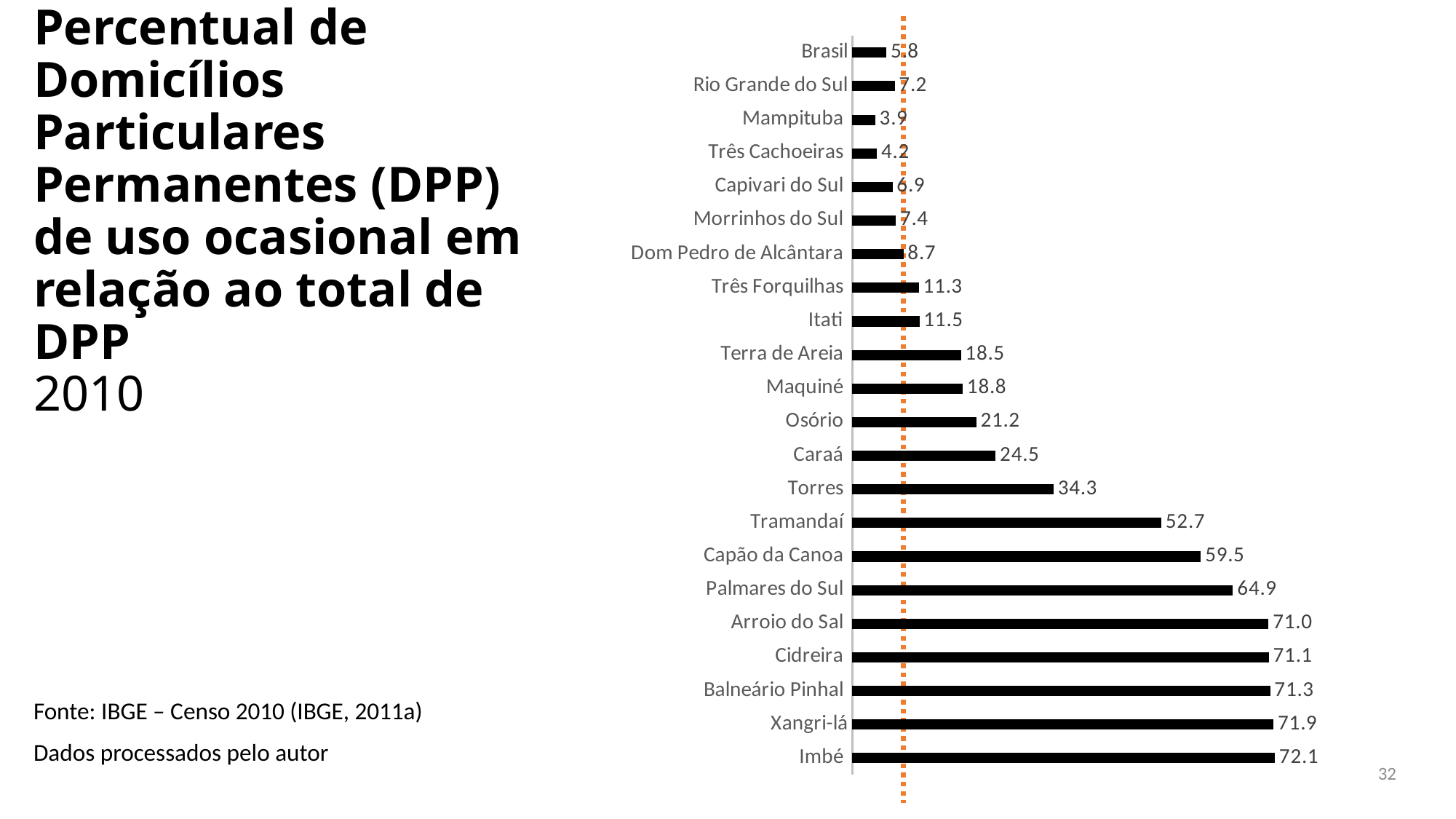
What is the value for Imbé? 72.1 Which category has the highest value? Imbé What is the difference between the values for Imbé and Brasil? 66.3 What is the value for Brasil? 5.8 Which has a larger value, Tramandaí or Torres? Tramandaí What is the difference between the values for Torres and Osório? 13.1 Which category has the lowest value? Mampituba What is the value for Torres? 34.3 What year does the chart title refer to? 2010 What kind of chart is shown on the slide? Bar chart What is the value for Rio Grande do Sul? 7.2 How many categories are shown in the chart? 22